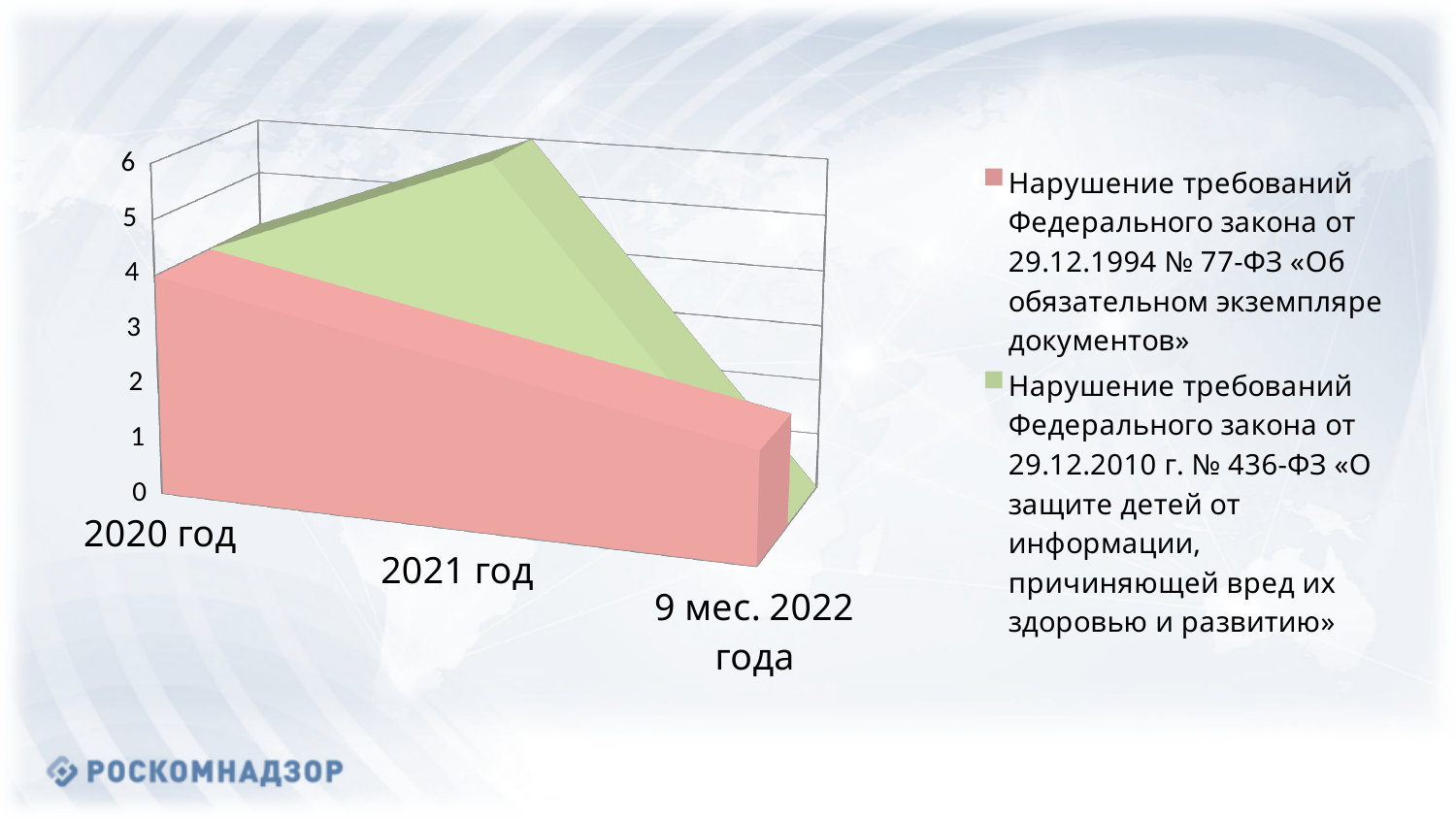
How many series does the legend list? 2 Is the value for 2020 год in the series «Нарушение требований Федерального закона от 29.12.1994 № 77-ФЗ» greater or less than 2? greater Is the value for 9 мес. 2022 года in the series «Нарушение требований Федерального закона от 29.12.1994 № 77-ФЗ» greater or less than 3? less Does the series «Нарушение требований Федерального закона от 29.12.1994 № 77-ФЗ» rise or fall from 2020 год to 9 мес. 2022 года? fall Which category has the highest value for the series «Нарушение требований Федерального закона от 29.12.2010 г. № 436-ФЗ»? 2021 год How many categories are shown on the x axis of the chart? 3 For the series «Нарушение требований Федерального закона от 29.12.2010 г. № 436-ФЗ», which is larger: the value for 2021 год or for 9 мес. 2022 года? 2021 год Is the value for 2021 год in the series «Нарушение требований Федерального закона от 29.12.2010 г. № 436-ФЗ» greater or less than 4? greater What kind of chart is shown on the slide? area chart Which category has the lowest value for the series «Нарушение требований Федерального закона от 29.12.2010 г. № 436-ФЗ»? 9 мес. 2022 года Which category has the lowest value for the series «Нарушение требований Федерального закона от 29.12.1994 № 77-ФЗ»? 9 мес. 2022 года Which colour represents the series «Нарушение требований Федерального закона от 29.12.2010 г. № 436-ФЗ» in the chart? green